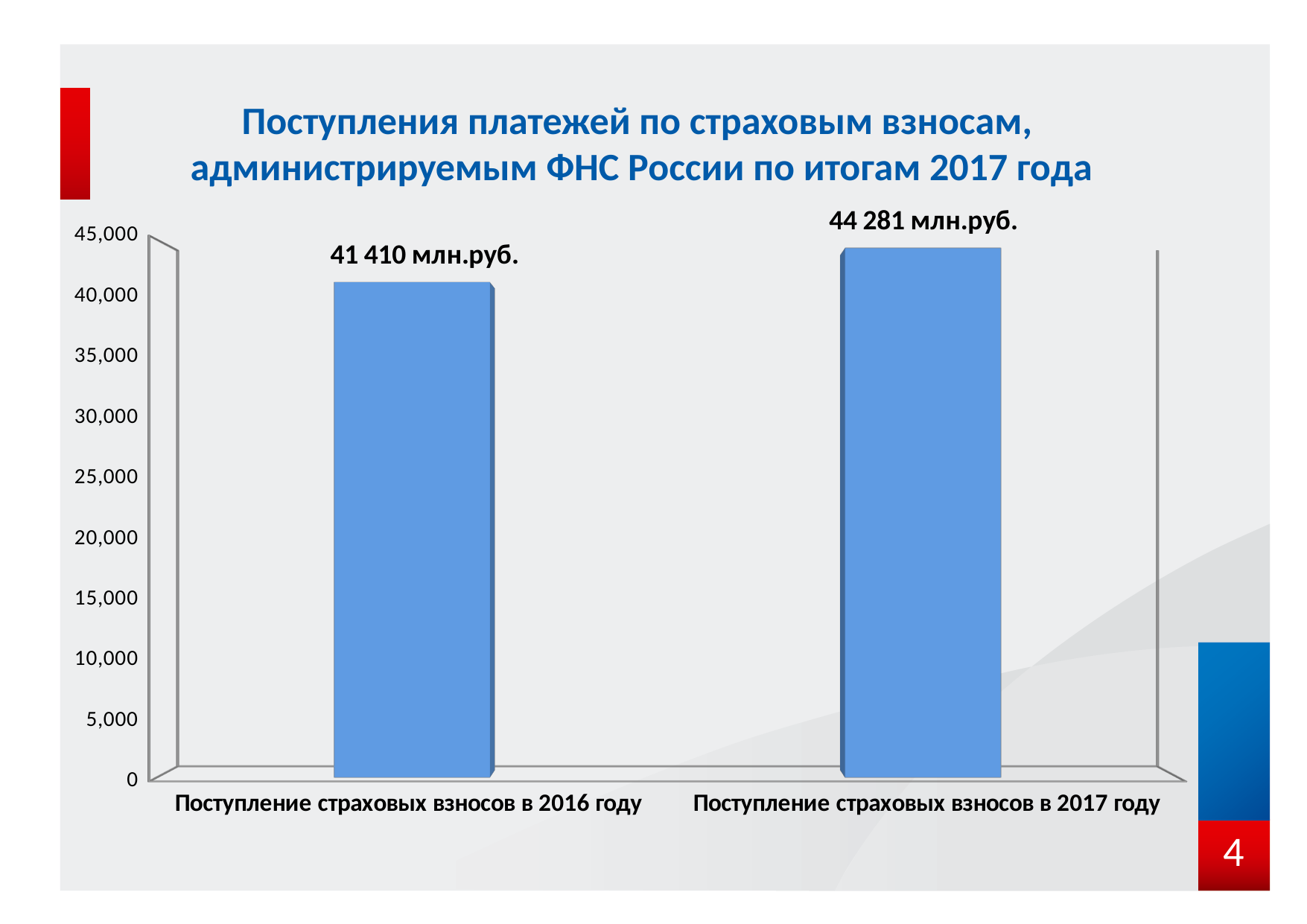
How many categories are shown on the chart? 2 Which category has the lowest value? Поступление страховых взносов в 2016 году Which is larger: the value for 2016 or the value for 2017? 2017 Which category has the highest value? Поступление страховых взносов в 2017 году What kind of chart is shown on the slide? bar chart Is the value for 'Поступление страховых взносов в 2017 году' greater or less than 45,000? less Is the value for 'Поступление страховых взносов в 2016 году' greater or less than 40,000? greater What is the value for 'Поступление страховых взносов в 2017 году'? 44 281 млн.руб. Do the values rise or fall from 2016 to 2017? rise What is the title of the chart? Поступления платежей по страховым взносам, администрируемым ФНС России по итогам 2017 года What is the difference between the 2017 and 2016 values? 2 871 млн.руб. What is the value for 'Поступление страховых взносов в 2016 году'? 41 410 млн.руб.